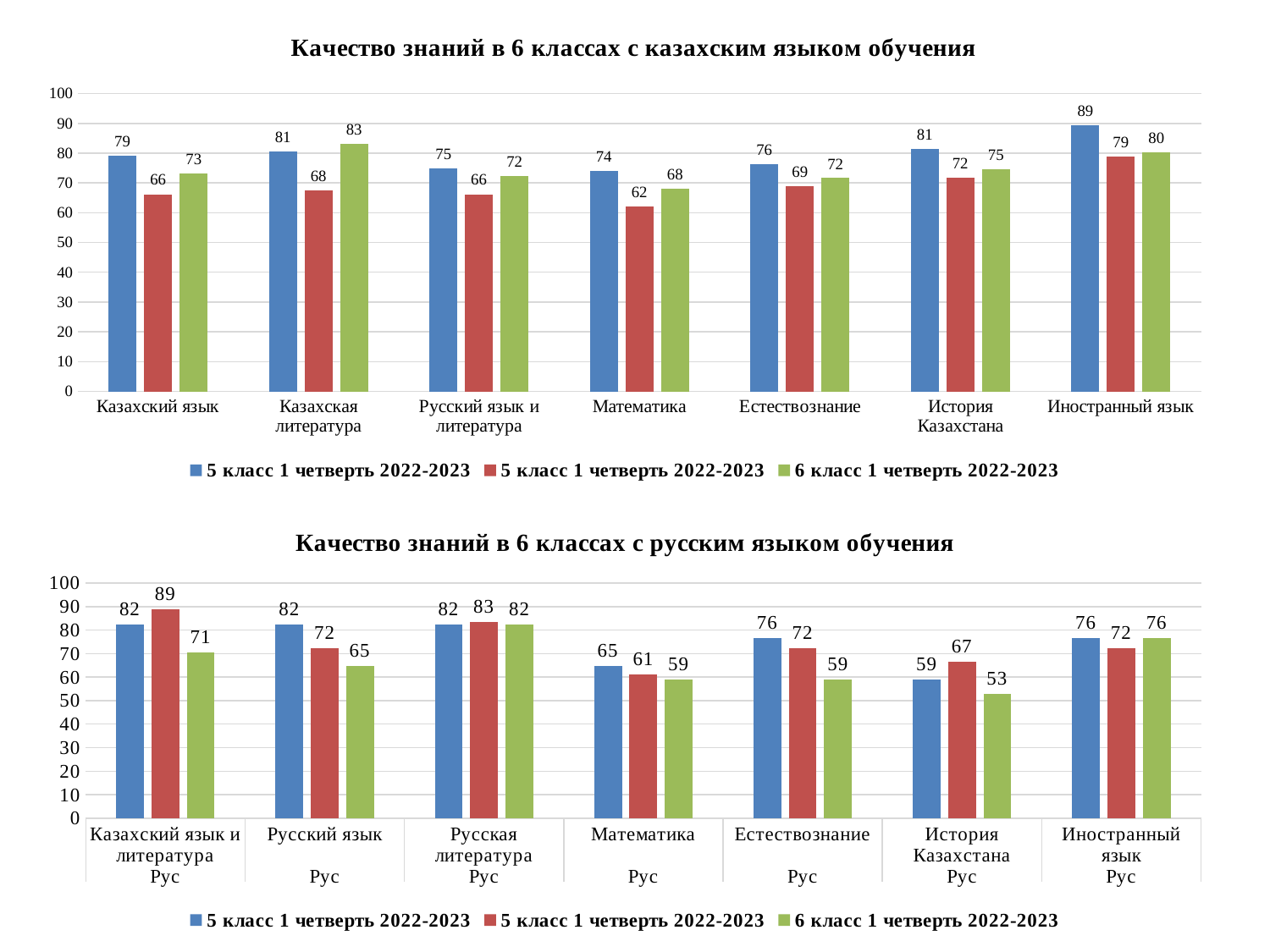
What kind of chart is the bottom chart (Качество знаний в 6 классах с русским языком обучения)? bar chart In the bottom chart (Качество знаний в 6 классах с русским языком обучения), what is the difference between the red bar and the green bar for История Казахстана Рус? 14 In the top chart (Качество знаний в 6 классах с казахским языком обучения), what is the difference between the blue bar and the red bar for Казахский язык? 13 In the bottom chart (Качество знаний в 6 классах с русским языком обучения), what is the value of the red bar for Казахский язык и литература Рус? 89 In the bottom chart (Качество знаний в 6 классах с русским языком обучения), which is larger for Русский язык Рус: the blue bar or the green bar? the blue bar In the top chart (Качество знаний в 6 классах с казахским языком обучения), which category has the lowest red bar? Математика In the bottom chart (Качество знаний в 6 классах с русским языком обучения), which category has the lowest green bar (6 класс 1 четверть 2022-2023)? История Казахстана Рус In the top chart (Качество знаний в 6 классах с казахским языком обучения), what is the value of the blue bar for Иностранный язык? 89 In the bottom chart (Качество знаний в 6 классах с русским языком обучения), what is the value of the green bar for Математика Рус? 59 In the top chart (Качество знаний в 6 классах с казахским языком обучения), what is the value of the green bar (6 класс 1 четверть 2022-2023) for Казахская литература? 83 In the top chart (Качество знаний в 6 классах с казахским языком обучения), how many series does the legend list? 3 In the top chart (Качество знаний в 6 классах с казахским языком обучения), how many categories are shown on the x axis? 7